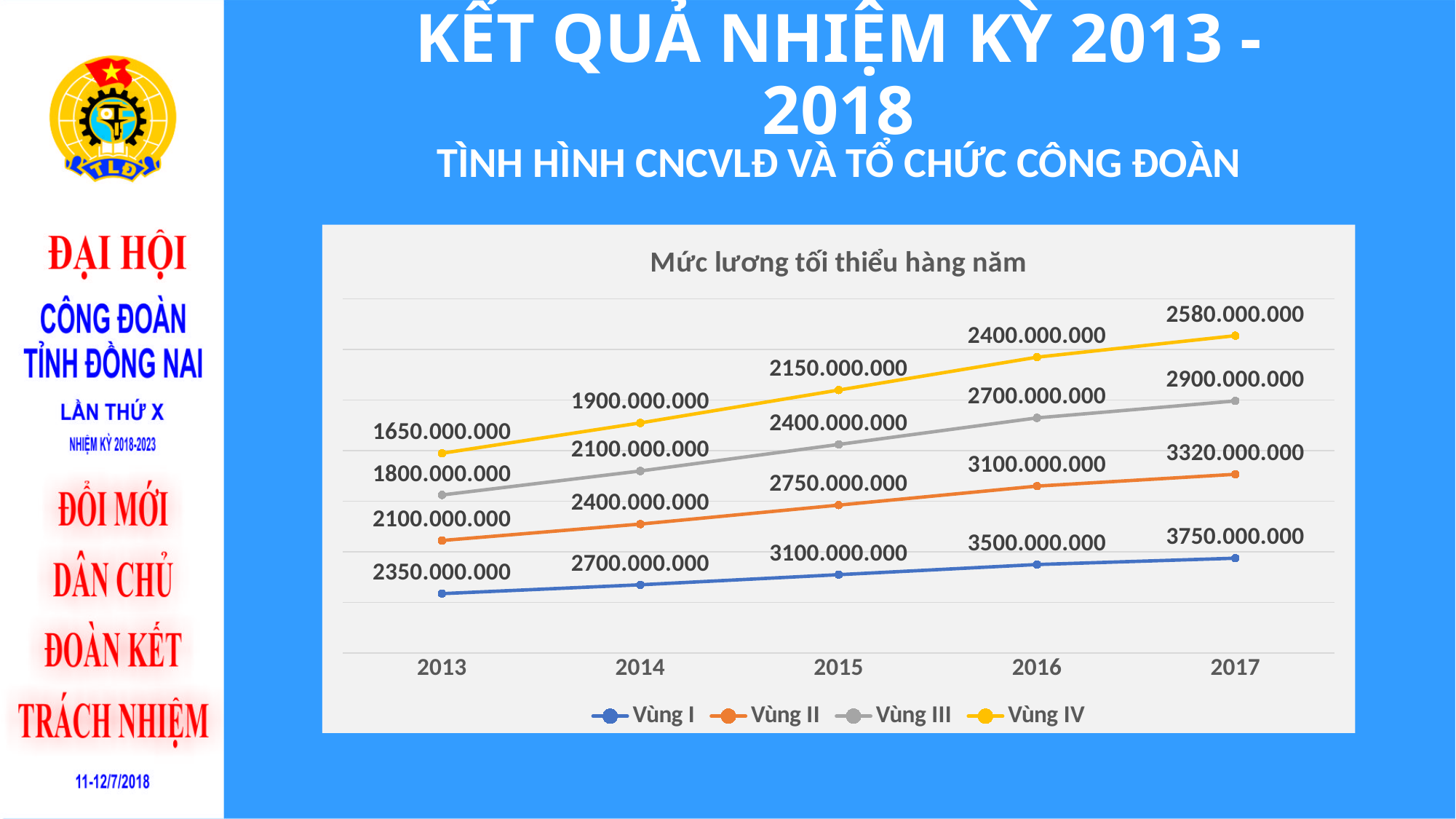
Which has the larger printed value in 2015: Vùng II or Vùng III? Vùng II How many series does the legend list? 4 How many years are shown on the x axis? 5 What is the value for Vùng II in 2016? 3100.000.000 What kind of chart is shown on the slide? Line chart Do the values for Vùng II rise or fall from 2013 to 2017? Rise In which year does Vùng I reach its highest value? 2017 In which year is the value for Vùng IV lowest? 2013 What is the value for Vùng III in 2015? 2400.000.000 What is the difference between the Vùng I values in 2017 and 2013? 1400.000.000 What is the value for Vùng IV in 2017? 2580.000.000 What is the value for Vùng I in 2013? 2350.000.000